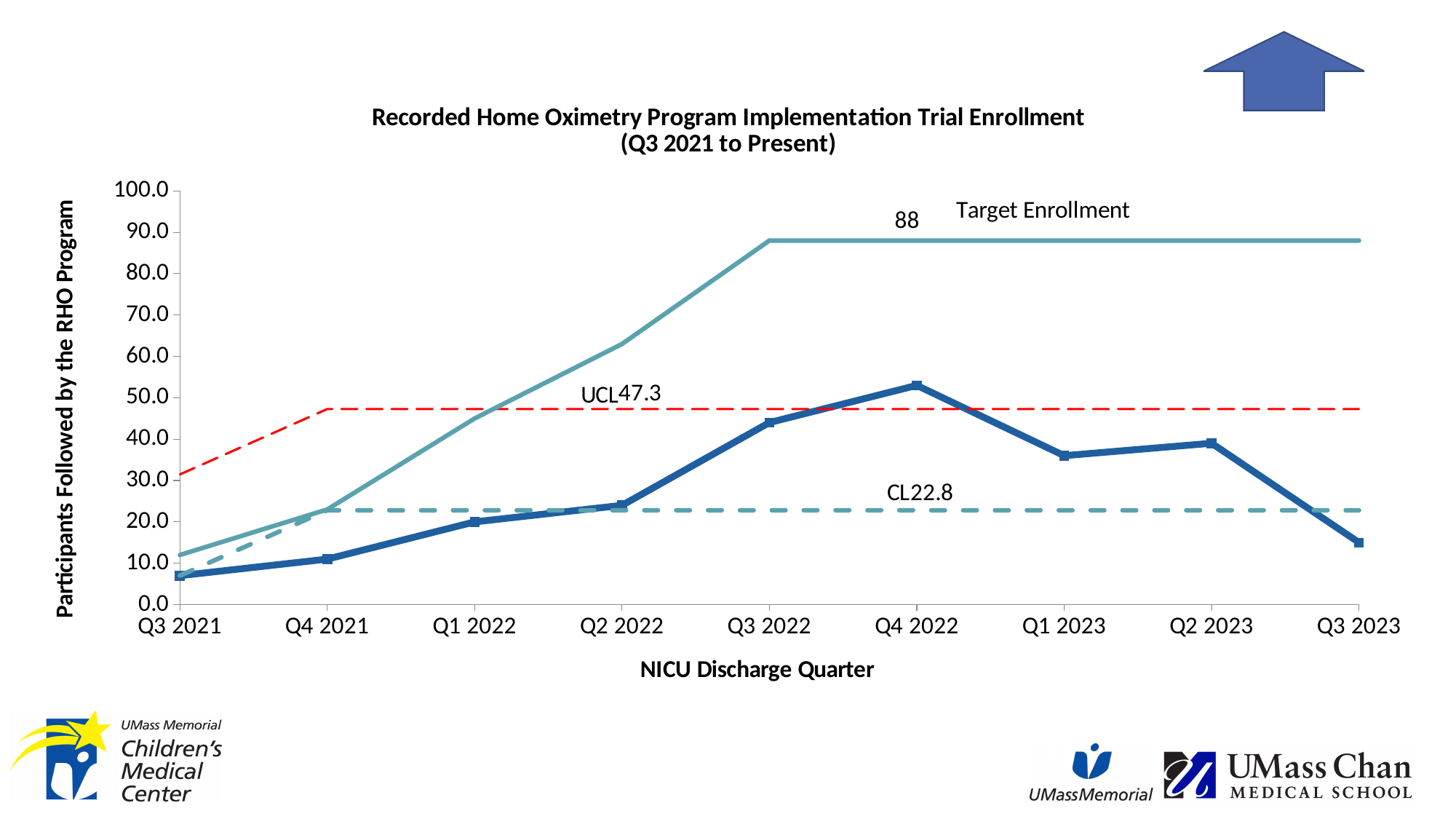
How many NICU discharge quarters are plotted along the x axis? 9 What value does the Target Enrollment line reach at its plateau? 88 What is the title of the x axis? NICU Discharge Quarter In which quarter does the actual participants line (dark blue with markers) reach its highest value? Q4 2022 What is the difference between the UCL and the CL values? 24.5 Which quarter has a higher actual participants value, Q3 2022 or Q1 2023? Q3 2022 What is the CL value labelled on the chart? 22.8 Is the actual participants value for Q1 2023 greater or less than 30? greater What kind of chart is shown on the slide? line chart In which quarter is the actual participants line (dark blue with markers) at its lowest value? Q3 2021 Is the actual participants value for Q3 2023 greater or less than 20? less What is the UCL value labelled on the chart? 47.3